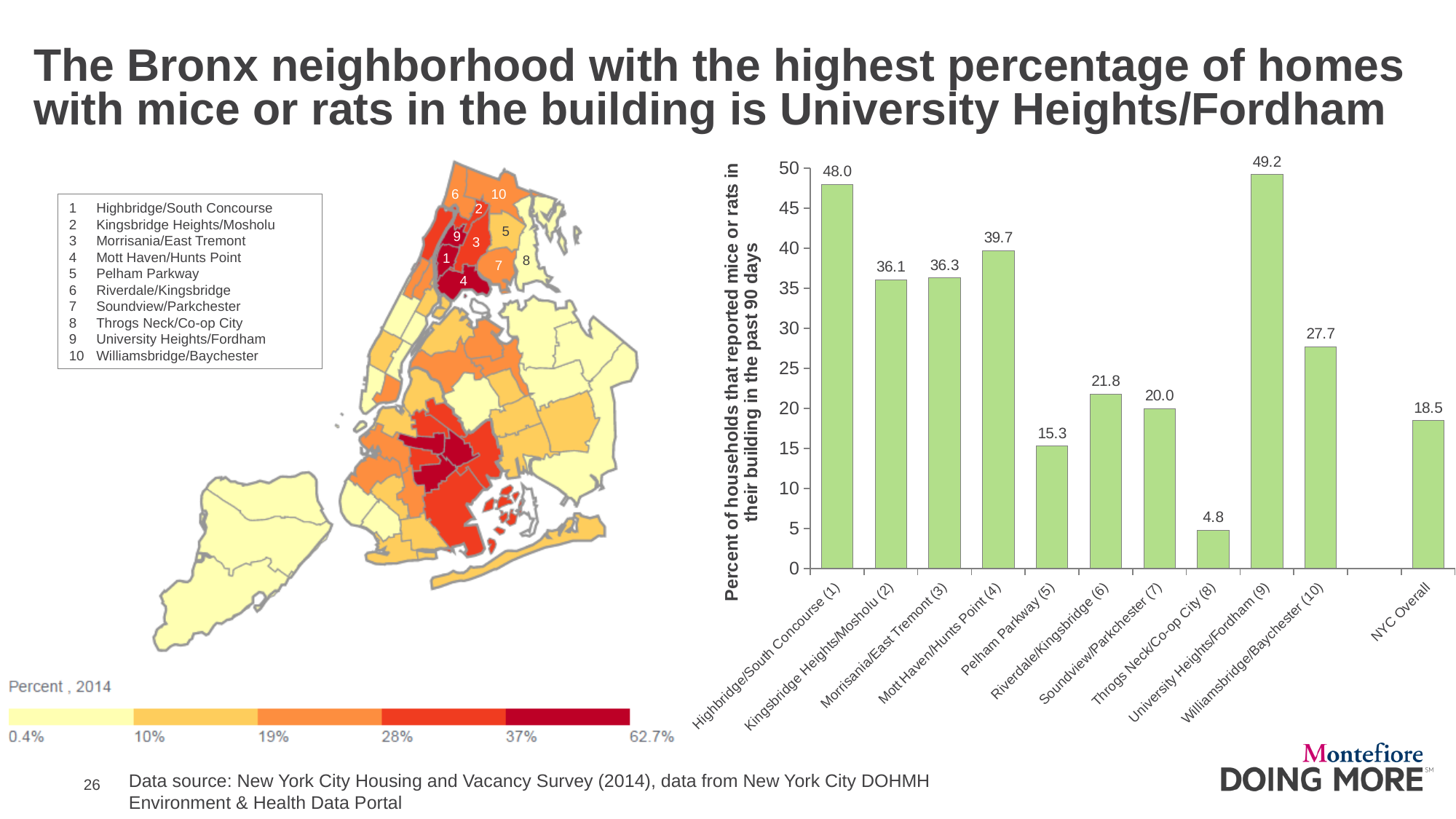
In the bar chart, how much higher is the value for Highbridge/South Concourse (1) than NYC Overall? 29.5 In the bar chart, what is the value for Pelham Parkway (5)? 15.3 In the bar chart, which is larger: the value for Riverdale/Kingsbridge (6) or Soundview/Parkchester (7)? Riverdale/Kingsbridge (6) In the bar chart, is the value for Williamsbridge/Baychester (10) greater or less than 25? greater In the bar chart, which category has the lowest value? Throgs Neck/Co-op City (8) In the bar chart, which neighborhood has the highest percentage of households reporting mice or rats? University Heights/Fordham (9) How many bars are shown in the bar chart? 11 In the bar chart, what percent of households in University Heights/Fordham (9) reported mice or rats in their building in the past 90 days? 49.2 What kind of chart is shown on the right side of the slide? bar chart What is the y-axis label of the bar chart? Percent of households that reported mice or rats in their building in the past 90 days In the bar chart, what is the value for NYC Overall? 18.5 In the bar chart, what is the difference between the values for University Heights/Fordham (9) and Highbridge/South Concourse (1)? 1.2